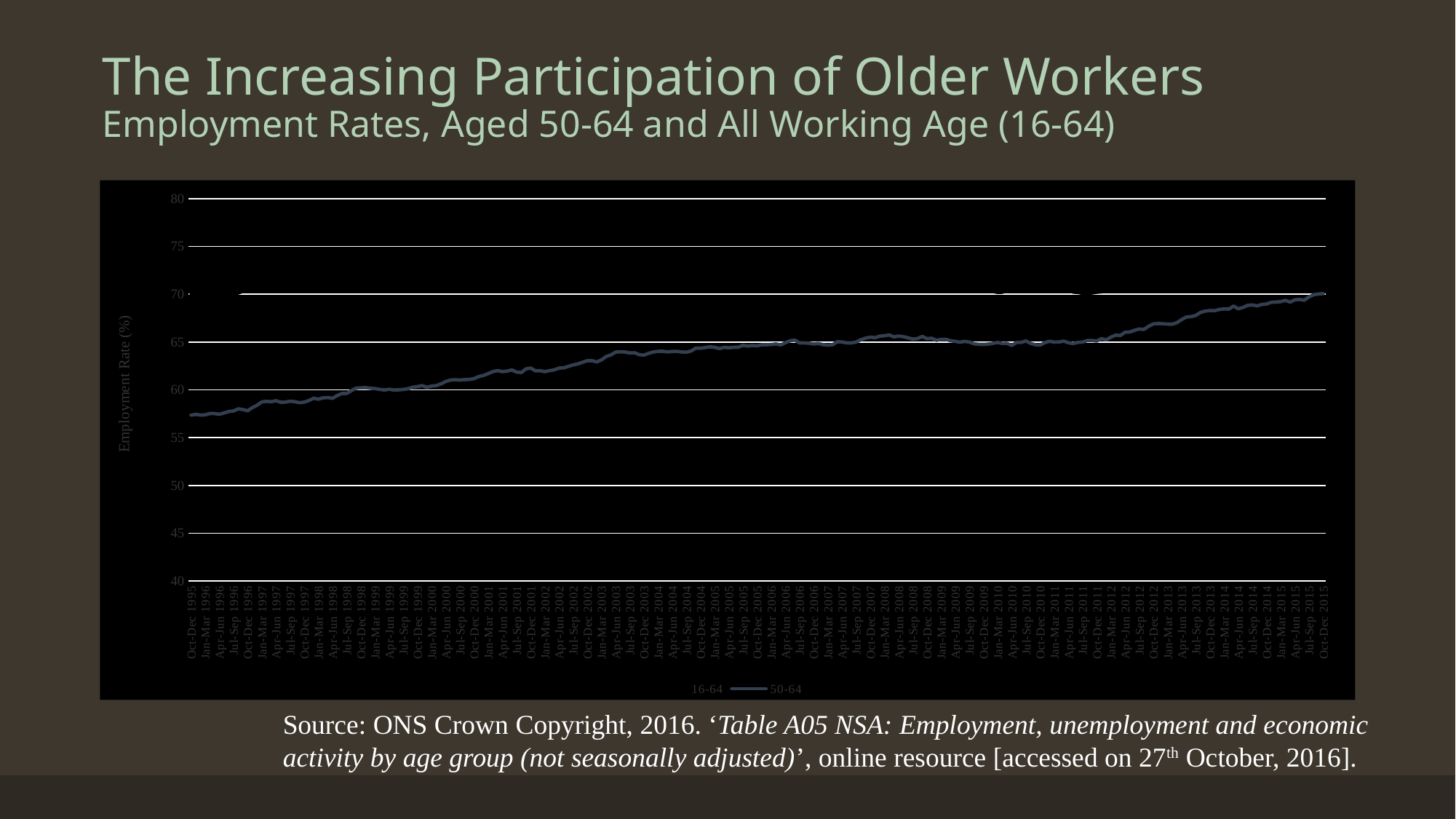
Is the 50-64 employment rate for Oct-Dec 2015 greater or less than 65? greater What are the two series named in the chart legend? 16-64 and 50-64 What is the label on the vertical axis of the chart? Employment Rate (%) Which is larger for the 50-64 series: the value for Oct-Dec 1995 or the value for Oct-Dec 2015? Oct-Dec 2015 What is the highest value shown on the vertical axis of the chart? 80 What kind of chart is shown on the slide? line chart Is the 50-64 employment rate for Jan-Mar 2003 greater or less than 65? less How many series does the chart legend list? 2 Is the 50-64 employment rate for Oct-Dec 1995 greater or less than 60? less Does the 50-64 employment rate rise or fall over the period shown on the x axis? rise At which period on the x axis is the 50-64 employment rate highest? Oct-Dec 2015 At which period on the x axis is the 50-64 employment rate lowest? Oct-Dec 1995